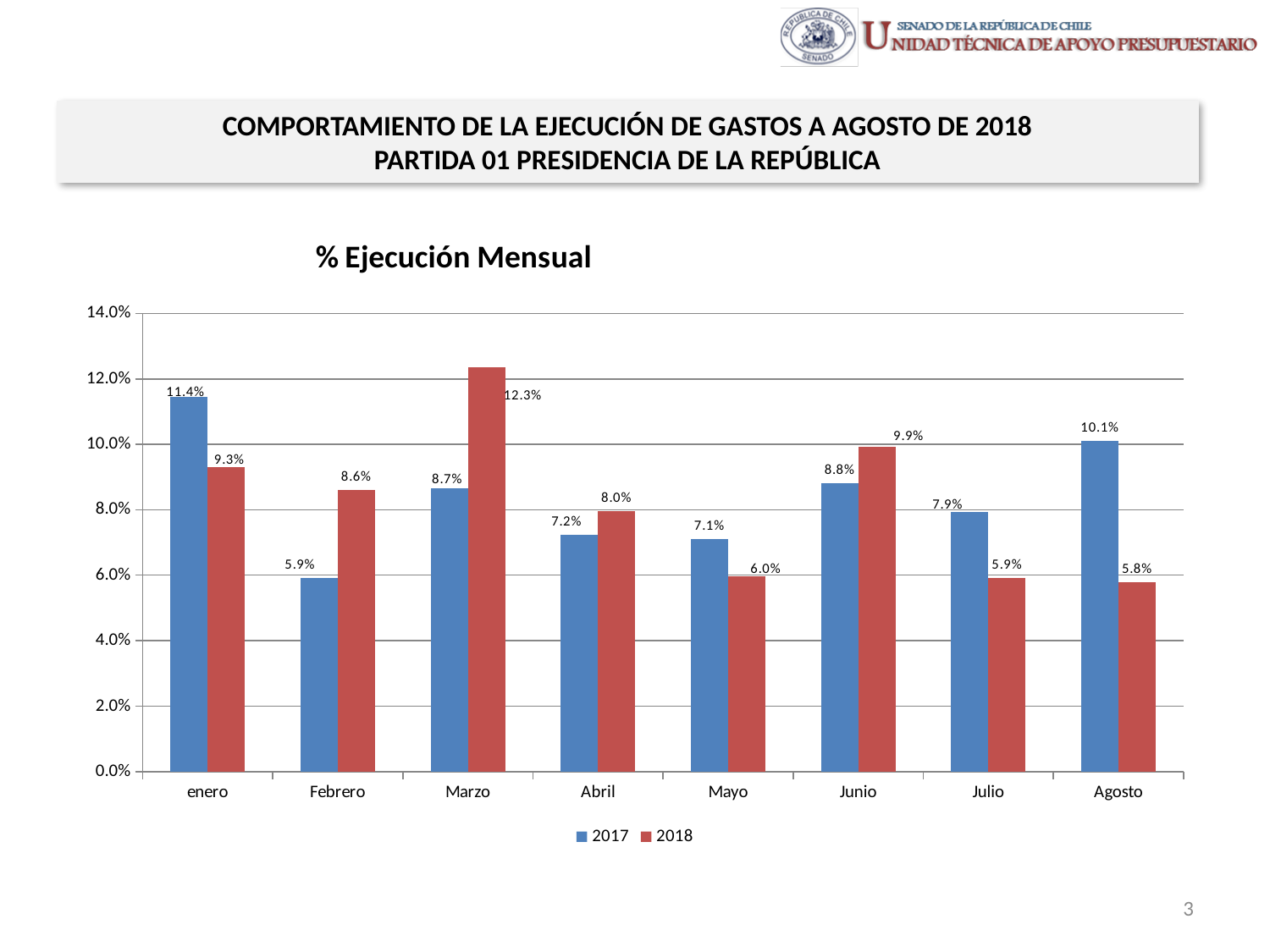
Which month has the lowest 2017 value? Febrero What is the 2017 value for Agosto? 10.1% What type of chart is shown on the slide? bar chart What is the difference between the 2017 and 2018 values for enero? 2.1 percentage points What is the title of the chart? % Ejecución Mensual What is the 2018 value for Marzo? 12.3% How many months are shown on the x axis? 8 Is the 2018 value for Junio greater or less than 8.0%? greater Which month has the highest 2018 value? Marzo What is the 2017 value for Mayo? 7.1% How many series does the legend list? 2 Which is larger for Julio, the 2017 value or the 2018 value? 2017